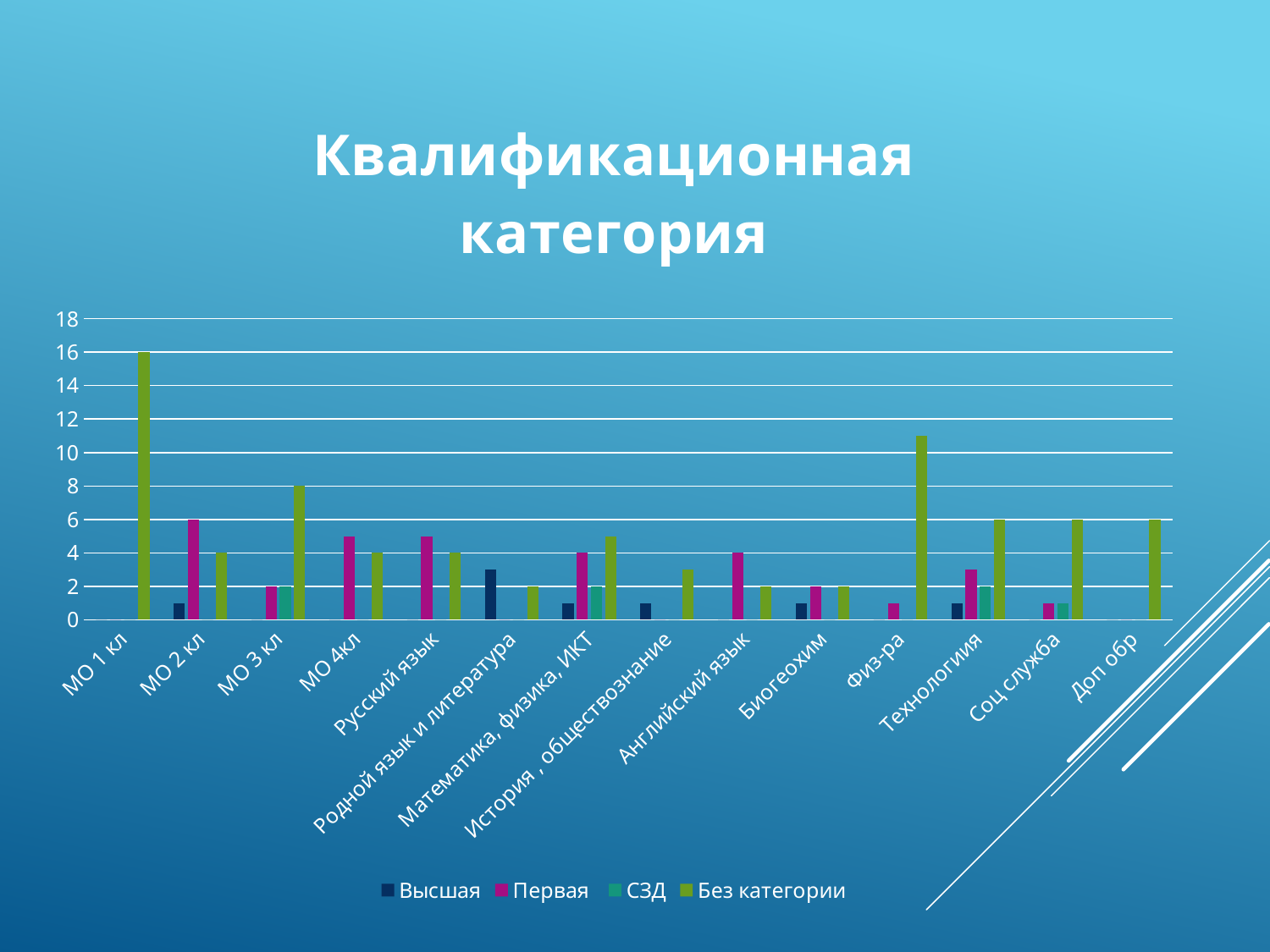
For МО 2 кл, which is larger: Первая or Без категории? Первая Is the value of Без категории for Физ-ра greater or less than 10? greater What is the value of Первая for МО 2 кл? 6 What is the value of Без категории for МО 1 кл? 16 Which category has the highest Без категории value? МО 1 кл Is the value of Первая for МО 4кл greater or less than 4? greater What is the difference between the Без категории values for МО 1 кл and МО 3 кл? 8 What kind of chart is shown on the slide? bar chart What is the value of Без категории for Доп обр? 6 How many series does the legend list? 4 What is the value of Без категории for МО 3 кл? 8 How many categories are shown along the x axis? 14